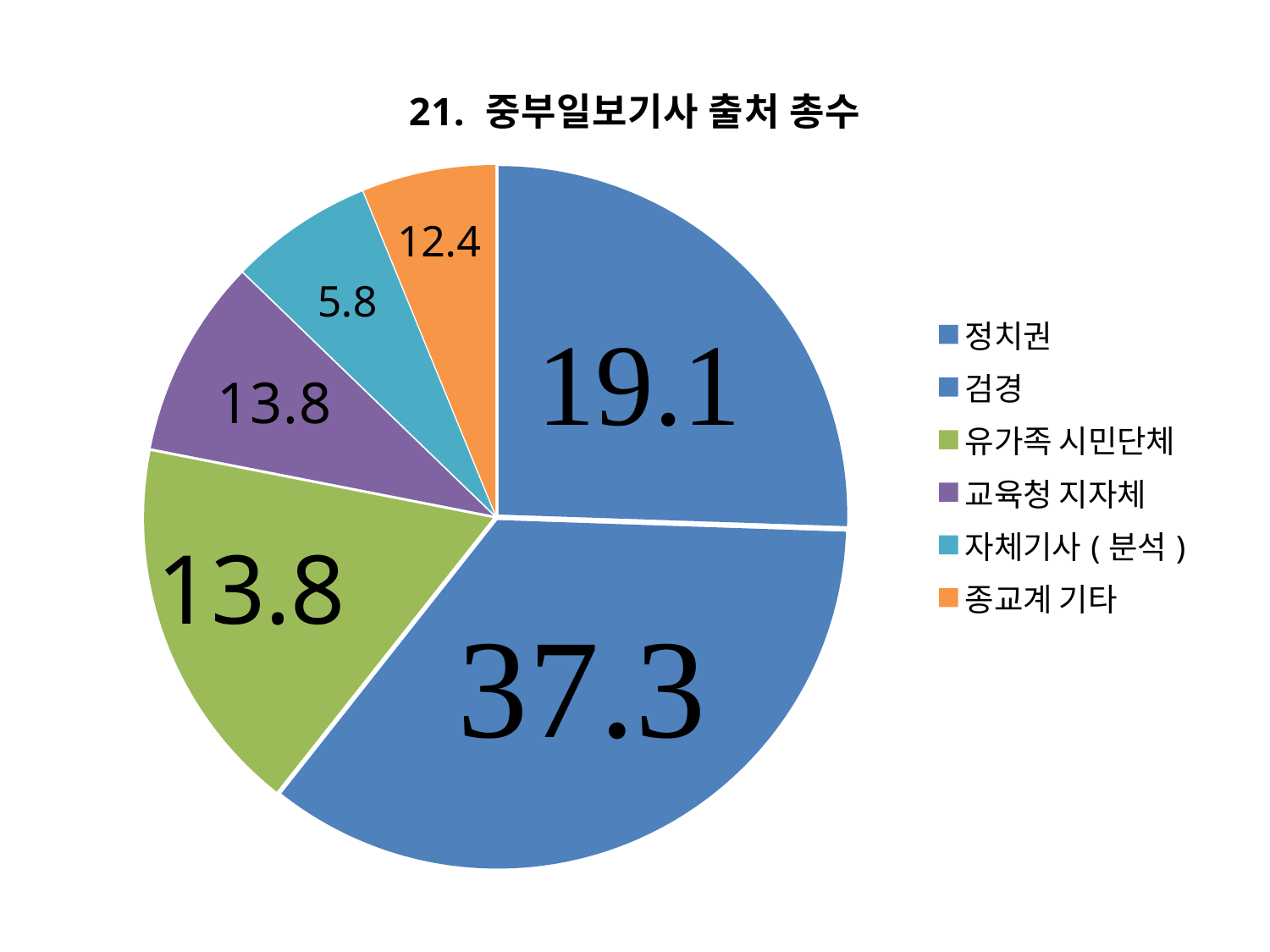
What colour is the slice for 종교계 기타? orange What type of chart is shown on the slide? pie chart Which is larger, the value for 정치권 or the value for 종교계 기타? 정치권 What is the value shown for 종교계 기타? 12.4 What is the value shown for 검경? 37.3 How many slices does the pie chart have? 6 What is the difference between the values for 검경 and 정치권? 18.2 What is the value shown for 정치권? 19.1 What is the title of the chart? 21. 중부일보기사 출처 총수 What is the value shown for 자체기사 ( 분석 )? 5.8 Which category has the largest slice? 검경